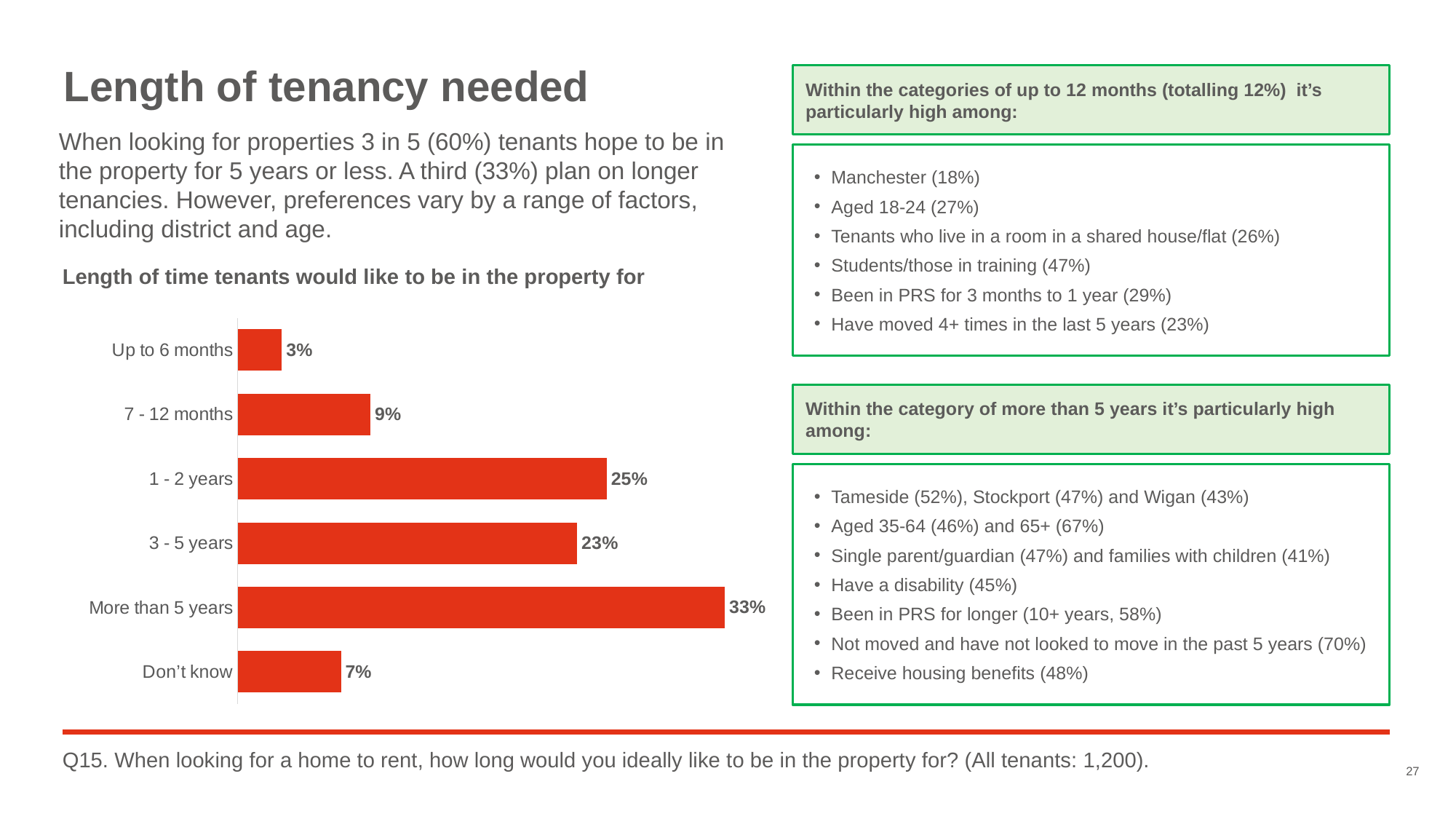
Which is larger, the value for '7 - 12 months' or the value for 'Don't know'? 7 - 12 months What is the difference in percentage points between 'More than 5 years' and '7 - 12 months'? 24 What is the difference in percentage points between '1 - 2 years' and '3 - 5 years'? 2 What percentage of tenants would like to be in the property for more than 5 years? 33% What is the title of the chart? Length of time tenants would like to be in the property for What percentage of tenants would like to be in the property for up to 6 months? 3% What percentage of tenants answered 'Don't know'? 7% Which category has the highest percentage? More than 5 years What percentage of tenants would like to be in the property for 1 - 2 years? 25% How many categories are shown in the chart? 6 What type of chart is shown on the slide? Bar chart Which category has the lowest percentage? Up to 6 months